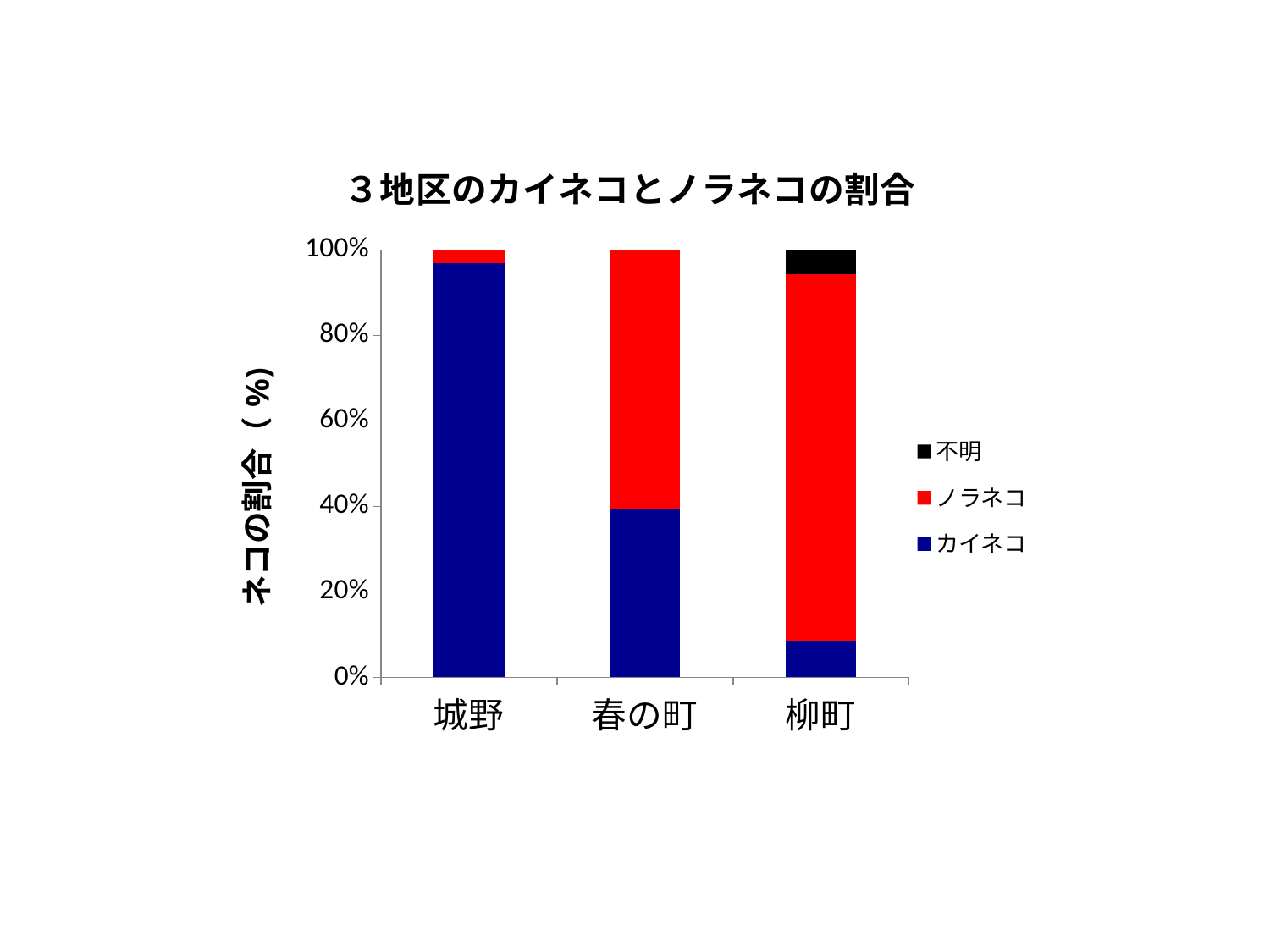
Is the カイネコ share for 城野 greater or less than 80%? greater How many districts (categories) are shown on the x axis? 3 Which district has the highest share of カイネコ? 城野 What is the title of the chart? ３地区のカイネコとノラネコの割合 Which series is shown in red in the legend? ノラネコ Which district has the lowest share of カイネコ? 柳町 Which is larger for 春の町, the カイネコ share or the ノラネコ share? ノラネコ Which district has the highest share of ノラネコ? 柳町 What kind of chart is shown on the slide? stacked bar chart Which district is the only one with a visible 不明 segment? 柳町 How many series does the legend list? 3